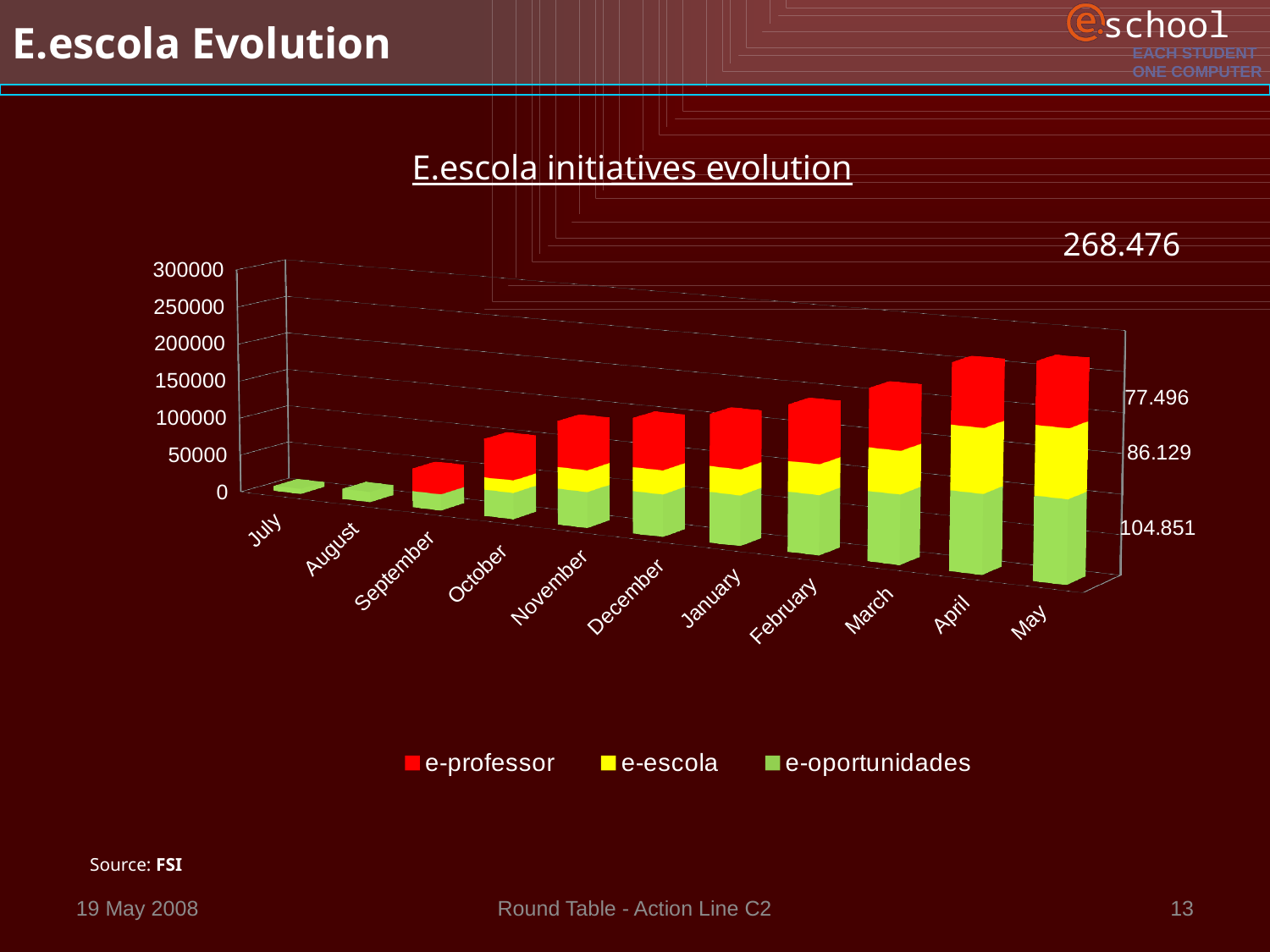
How many months are shown on the x axis? 11 What kind of chart is shown on the slide? Stacked bar chart How many series does the legend list? 3 What is the difference between the e-oportunidades and e-professor values for May? 27.355 Is the total value for July greater or less than 50000? less Which month has the lowest total value? July What is the value of e-professor for May? 77.496 What is the value of e-escola for May? 86.129 What is the total value shown for May across all three initiatives? 268.476 In May, which is larger: e-oportunidades or e-professor? e-oportunidades Do the total values rise or fall from July to May? Rise What is the value of e-oportunidades for May? 104.851